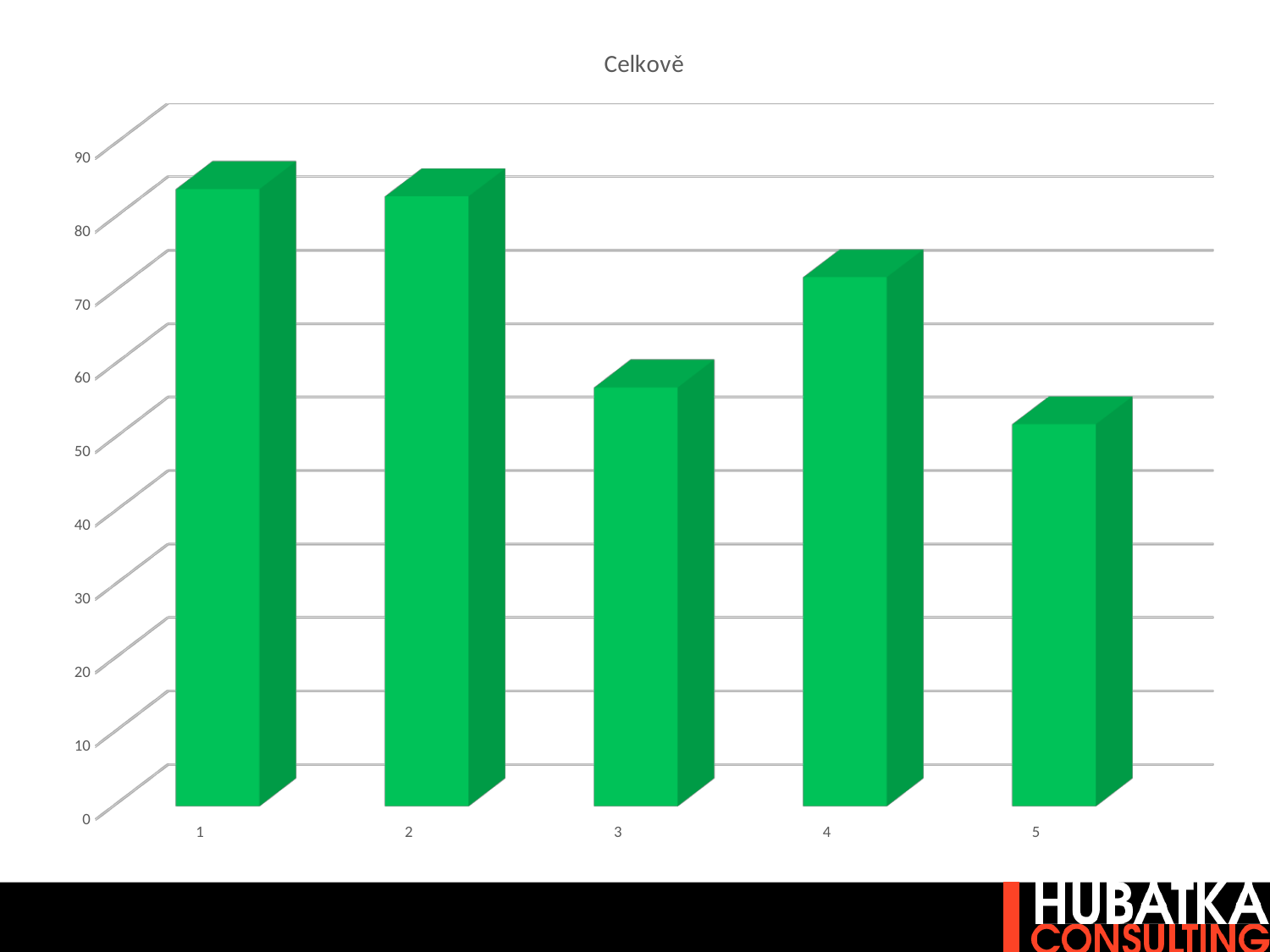
Which category has the lowest bar? 5 Is the value for category 5 greater or less than 60? less Which is larger, the value for category 3 or the value for category 5? 3 What kind of chart is shown on the slide? bar chart Is the value for category 3 greater or less than 70? less Which is larger, the value for category 1 or the value for category 4? 1 Is the value for category 4 greater or less than 70? greater Which is larger, the value for category 3 or the value for category 4? 4 What colour are the bars in the chart? green What is the title of the chart? Celkově How many categories are plotted on the x axis? 5